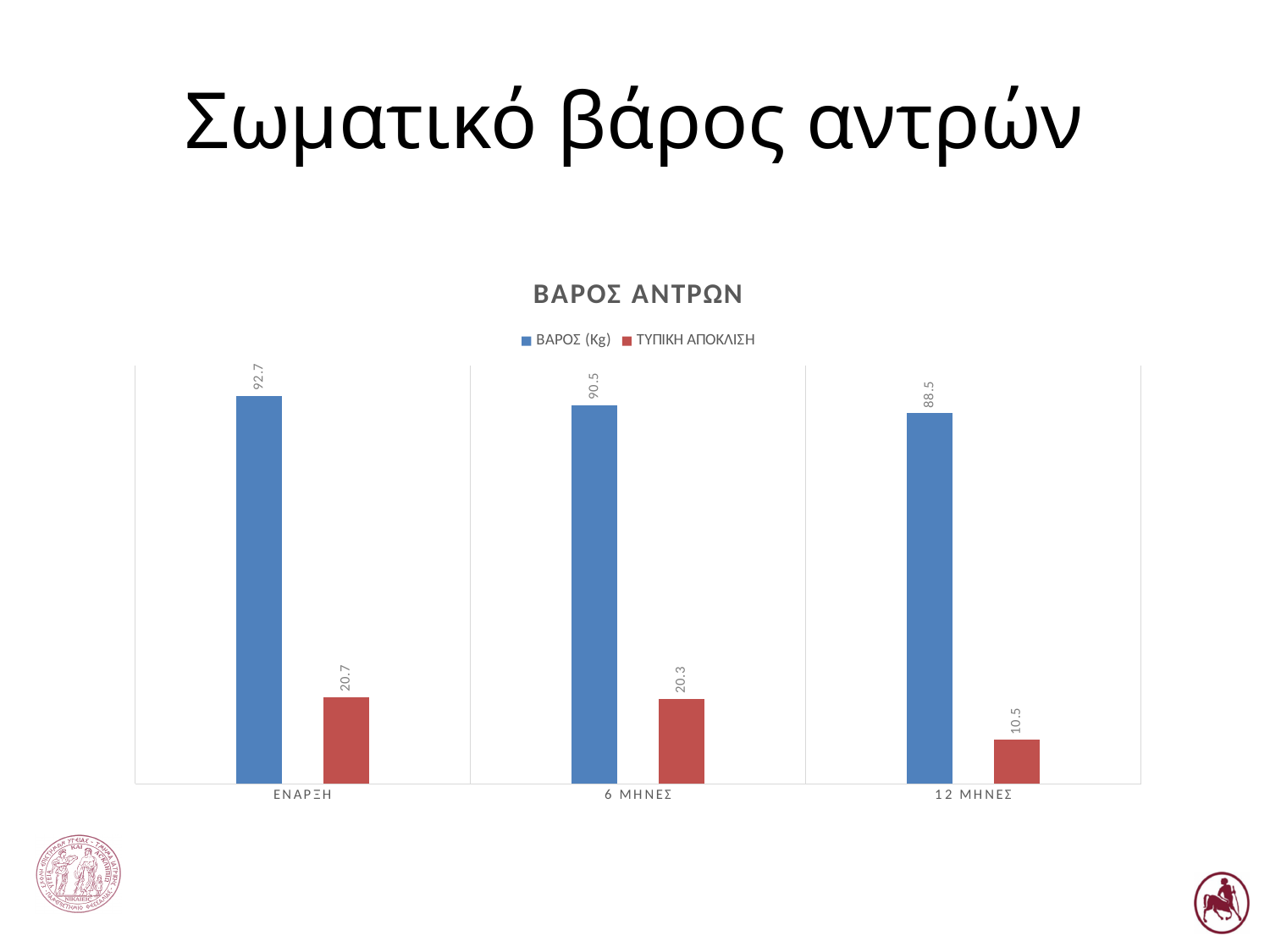
How many series does the legend list? 2 What kind of chart is shown? bar chart What is the ΒΑΡΟΣ (Kg) value for ΕΝΑΡΞΗ? 92.7 What is the difference between the ΒΑΡΟΣ (Kg) values for ΕΝΑΡΞΗ and 12 ΜΗΝΕΣ? 4.2 What is the title of the chart? ΒΑΡΟΣ ΑΝΤΡΩΝ Do the ΒΑΡΟΣ (Kg) values rise or fall from ΕΝΑΡΞΗ to 12 ΜΗΝΕΣ? fall Which category has the highest ΒΑΡΟΣ (Kg) value? ΕΝΑΡΞΗ Which category has the lowest ΤΥΠΙΚΗ ΑΠΟΚΛΙΣΗ value? 12 ΜΗΝΕΣ What is the ΒΑΡΟΣ (Kg) value for 6 ΜΗΝΕΣ? 90.5 What is the ΤΥΠΙΚΗ ΑΠΟΚΛΙΣΗ value for 12 ΜΗΝΕΣ? 10.5 How many categories are shown on the x axis? 3 Which is larger, the ΤΥΠΙΚΗ ΑΠΟΚΛΙΣΗ value for ΕΝΑΡΞΗ or for 12 ΜΗΝΕΣ? ΕΝΑΡΞΗ